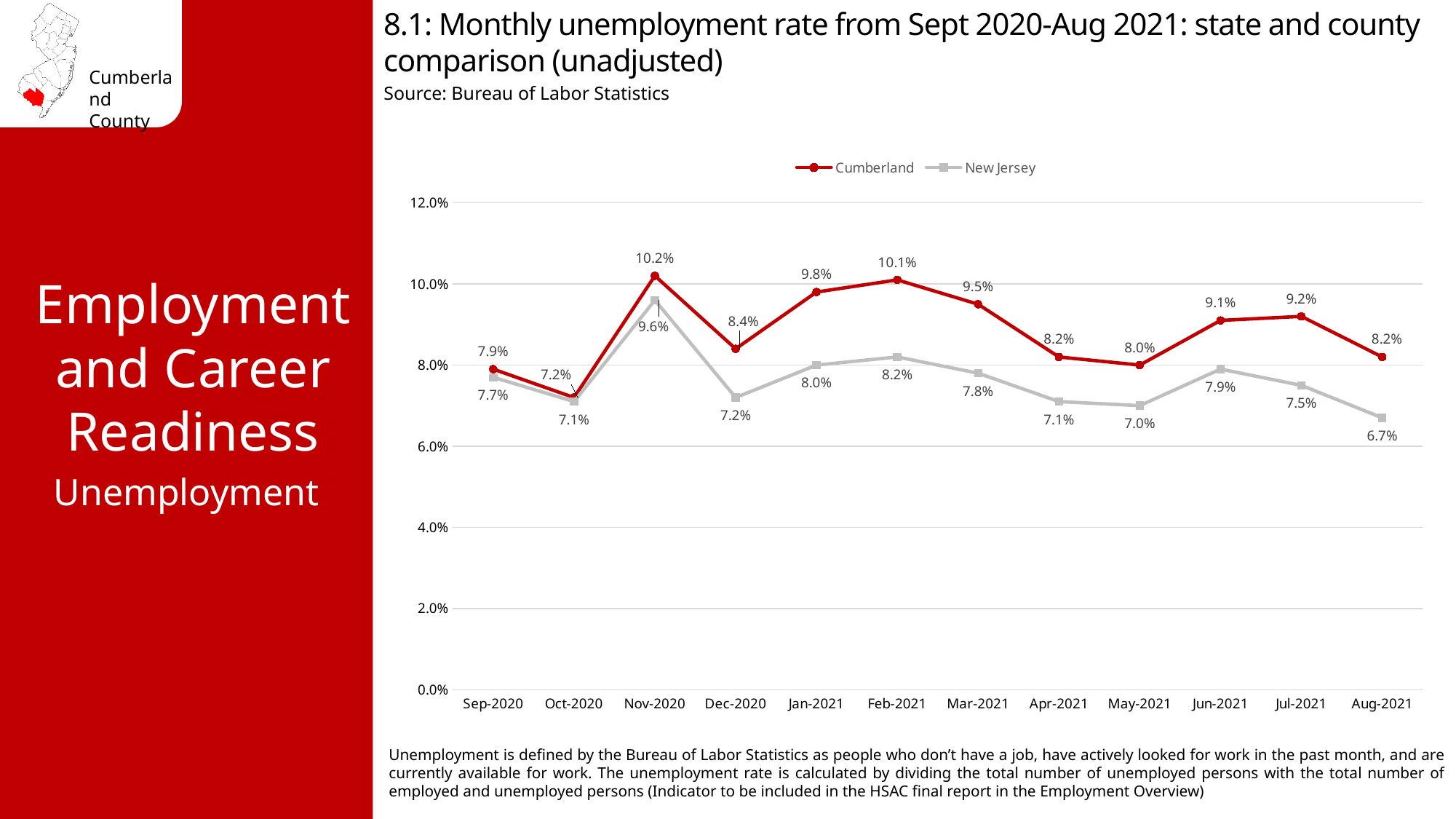
What was the Cumberland unemployment rate in Feb-2021? 10.1% What was the Cumberland unemployment rate in Nov-2020? 10.2% What was the New Jersey unemployment rate in Aug-2021? 6.7% Which had the higher unemployment rate in Jan-2021, Cumberland or New Jersey? Cumberland In which month was the New Jersey unemployment rate lowest? Aug-2021 Did the New Jersey unemployment rate rise or fall from Jun-2021 to Aug-2021? Fall In which month was the Cumberland unemployment rate highest? Nov-2020 What type of chart is shown on the slide? Line chart What is the difference between the Cumberland and New Jersey unemployment rates in Aug-2021? 1.5 percentage points In which month was the Cumberland unemployment rate lowest? Oct-2020 How many series does the legend list? 2 How many months are plotted on the x axis? 12